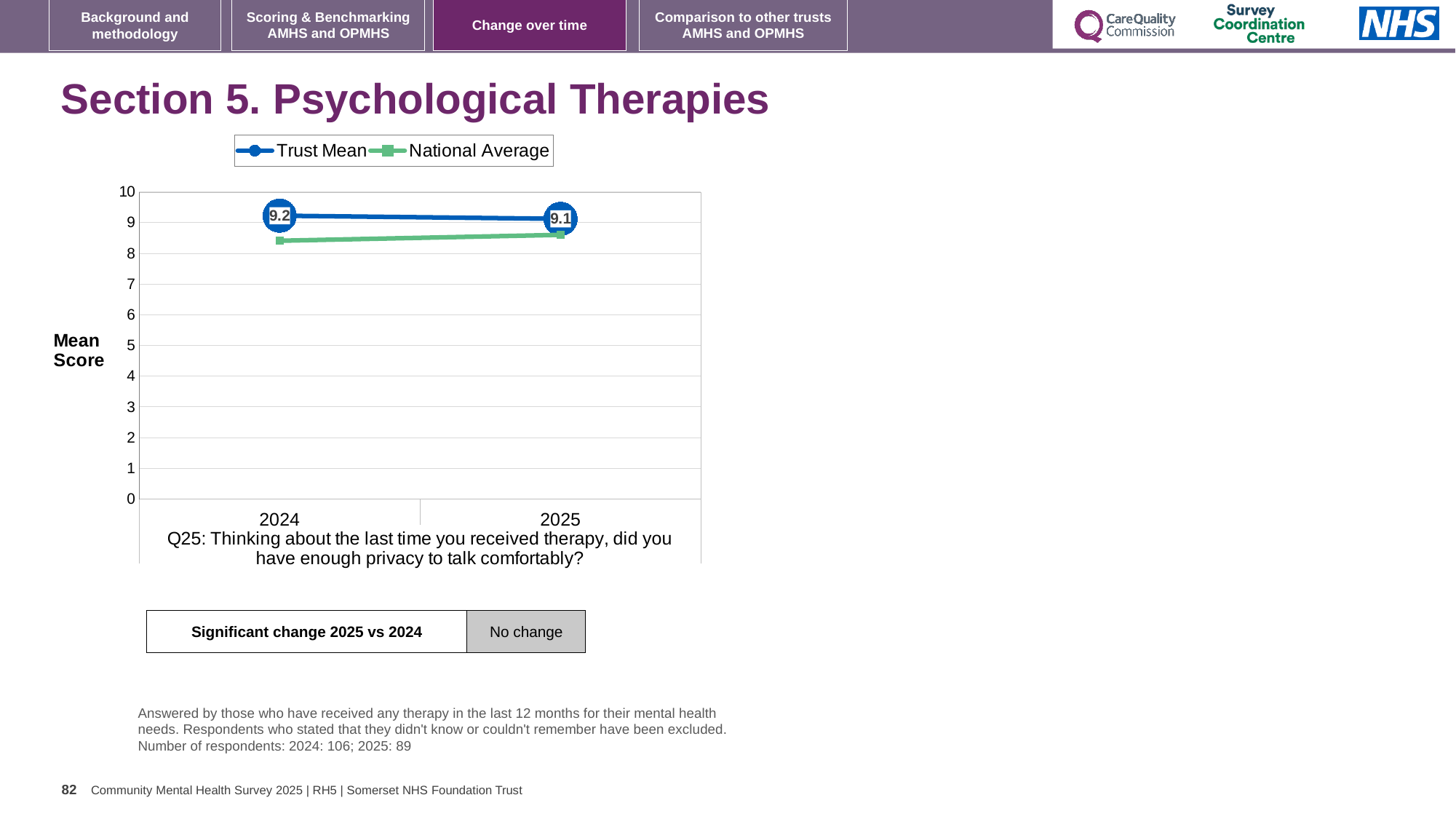
How many series does the legend list? 2 How many years are plotted on the x axis? 2 Which year has the higher Trust Mean, 2024 or 2025? 2024 Is the National Average value for 2024 greater or less than 9? less Does the Trust Mean rise or fall from 2024 to 2025? Fall By how much did the Trust Mean change between 2024 and 2025? 0.1 Is the National Average value for 2025 greater or less than 8? greater What kind of chart is shown on the slide? Line chart What is the Trust Mean value for 2025? 9.1 What is the Trust Mean value for 2024? 9.2 What is the label on the y axis of the chart? Mean Score In 2024, which series is higher, Trust Mean or National Average? Trust Mean